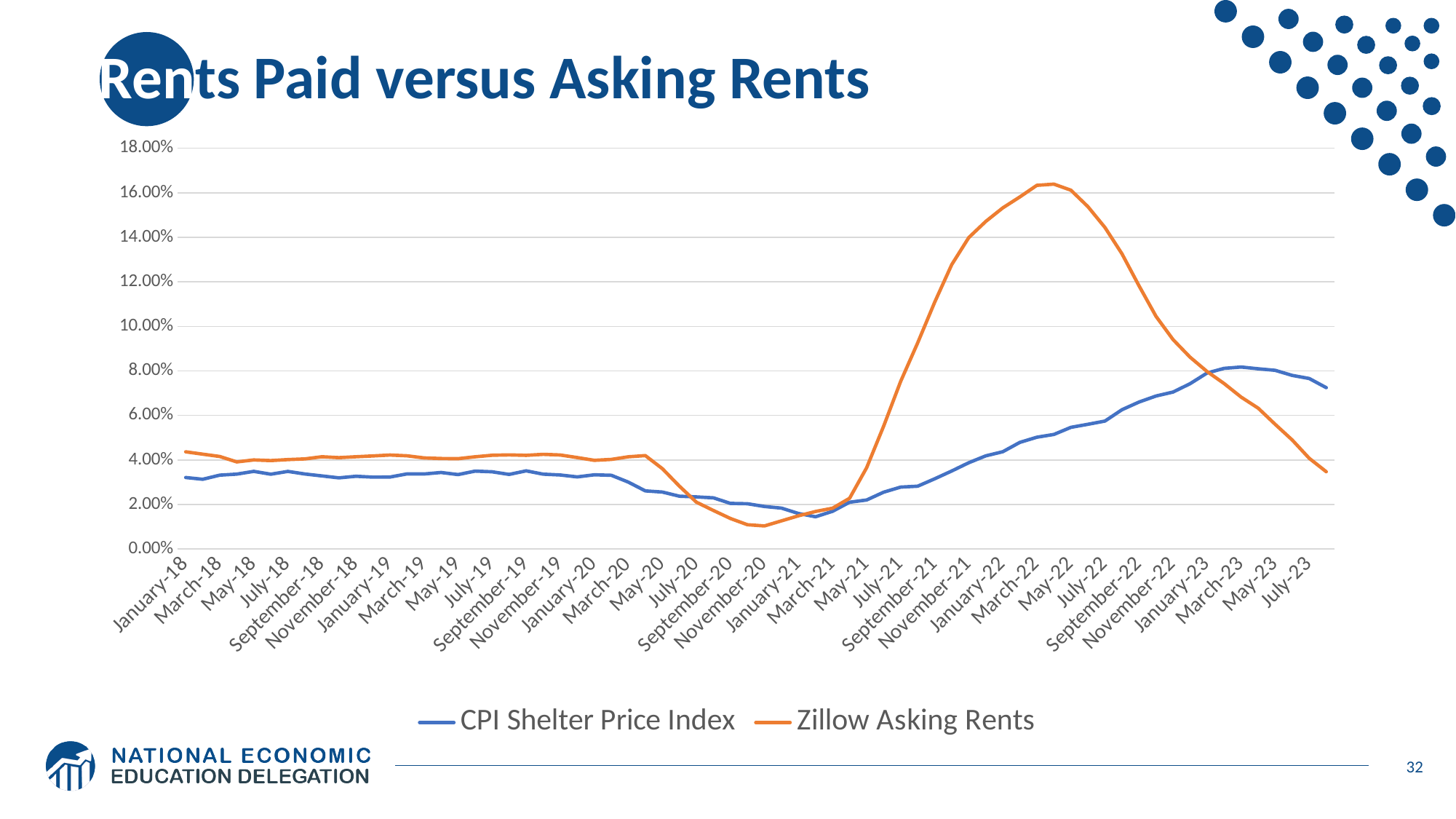
Which series reaches the highest value anywhere on the chart? Zillow Asking Rents Is the value for CPI Shelter Price Index in January-18 greater or less than 4.00%? less What kind of chart is shown on the slide? line chart In March-22, which series has the higher value, CPI Shelter Price Index or Zillow Asking Rents? Zillow Asking Rents Is the value for Zillow Asking Rents in March-22 greater or less than 14.00%? greater In July-23, which series has the higher value, CPI Shelter Price Index or Zillow Asking Rents? CPI Shelter Price Index What are the two series named in the legend? CPI Shelter Price Index and Zillow Asking Rents What is the title of the chart? Rents Paid versus Asking Rents Does the Zillow Asking Rents line rise or fall between March-22 and July-23? fall How many series does the legend list? 2 Is the value for CPI Shelter Price Index in March-23 greater or less than 6.00%? greater